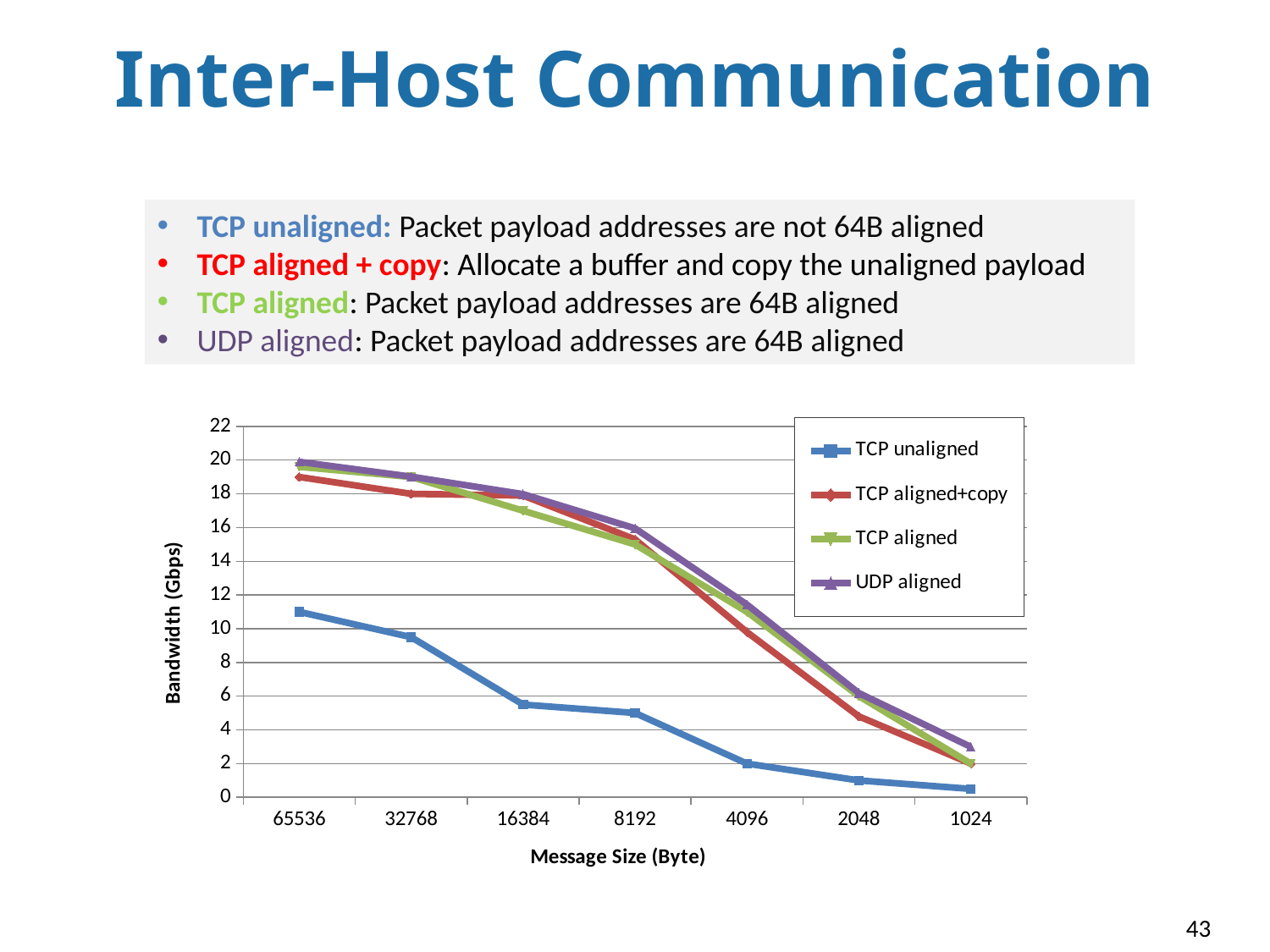
Is the bandwidth for TCP unaligned at message size 65536 greater or less than 10 Gbps? greater Do the bandwidth values rise or fall as you move from left to right along the x axis? fall Which series has the lowest bandwidth at message size 65536? TCP unaligned How many message sizes are plotted along the x axis? 7 Is the bandwidth for TCP unaligned at message size 4096 greater or less than 4 Gbps? less Is the bandwidth for TCP aligned+copy at message size 2048 greater or less than 6 Gbps? less At message size 2048, which has the higher bandwidth: TCP aligned+copy or UDP aligned? UDP aligned Which series has the highest bandwidth at message size 1024? UDP aligned What is the label of the y axis? Bandwidth (Gbps) What kind of chart is shown on the slide? line chart How many series does the chart legend list? 4